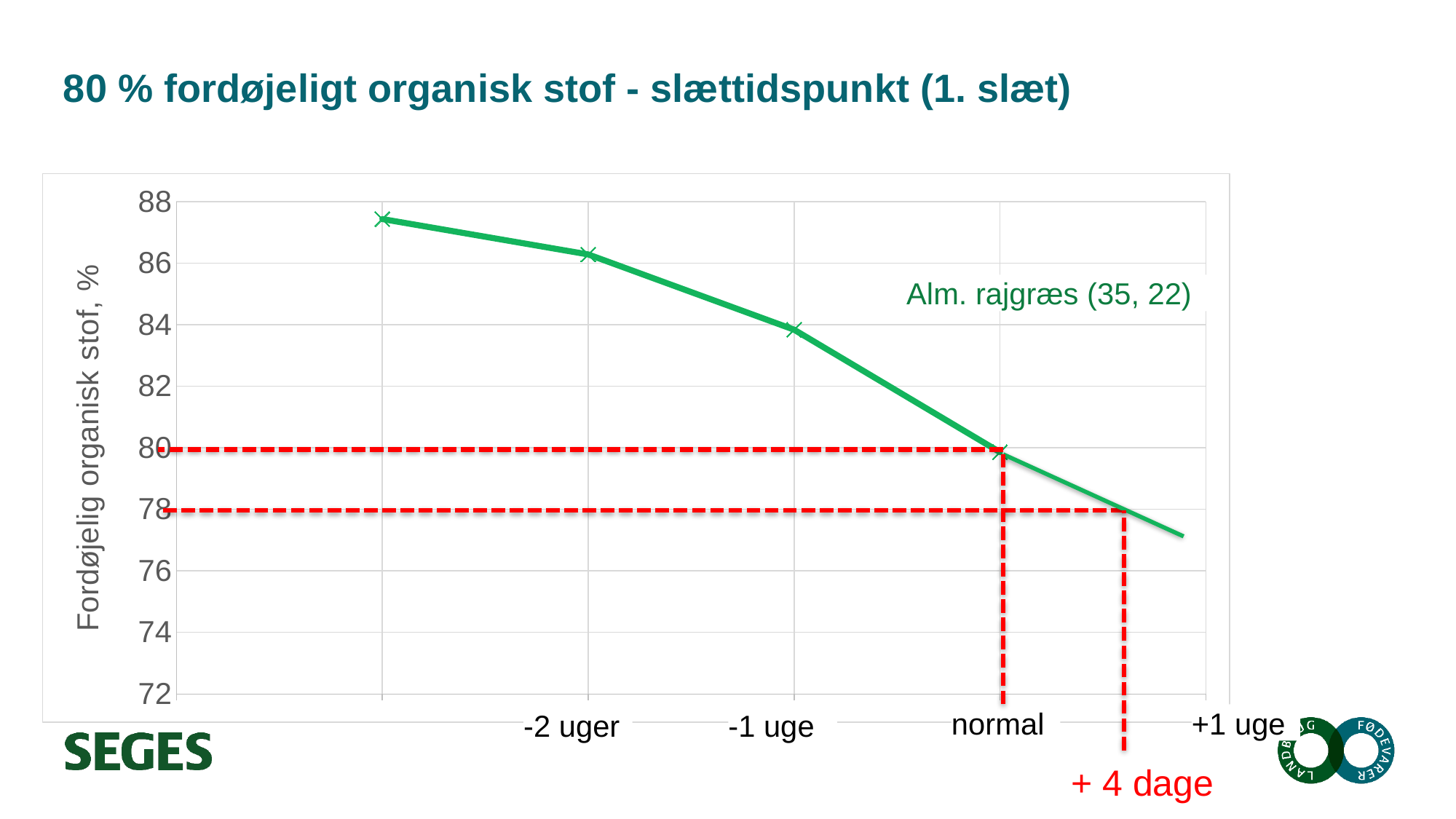
Is the value for -2 uger greater or less than 84? greater What kind of chart is shown on the slide? line chart Is the value for -1 uge greater or less than 86? less How many data series are plotted on the chart? 1 What is the title of the y axis? Fordøjelig organisk stof, % Is the value for -1 uge greater or less than 82? greater Which has the higher value, -2 uger or -1 uge? -2 uger What is the name of the series plotted on the chart? Alm. rajgræs (35, 22) Do the values rise or fall moving from left to right along the x axis? fall Which of the labelled x-axis categories has the lowest value? +1 uge